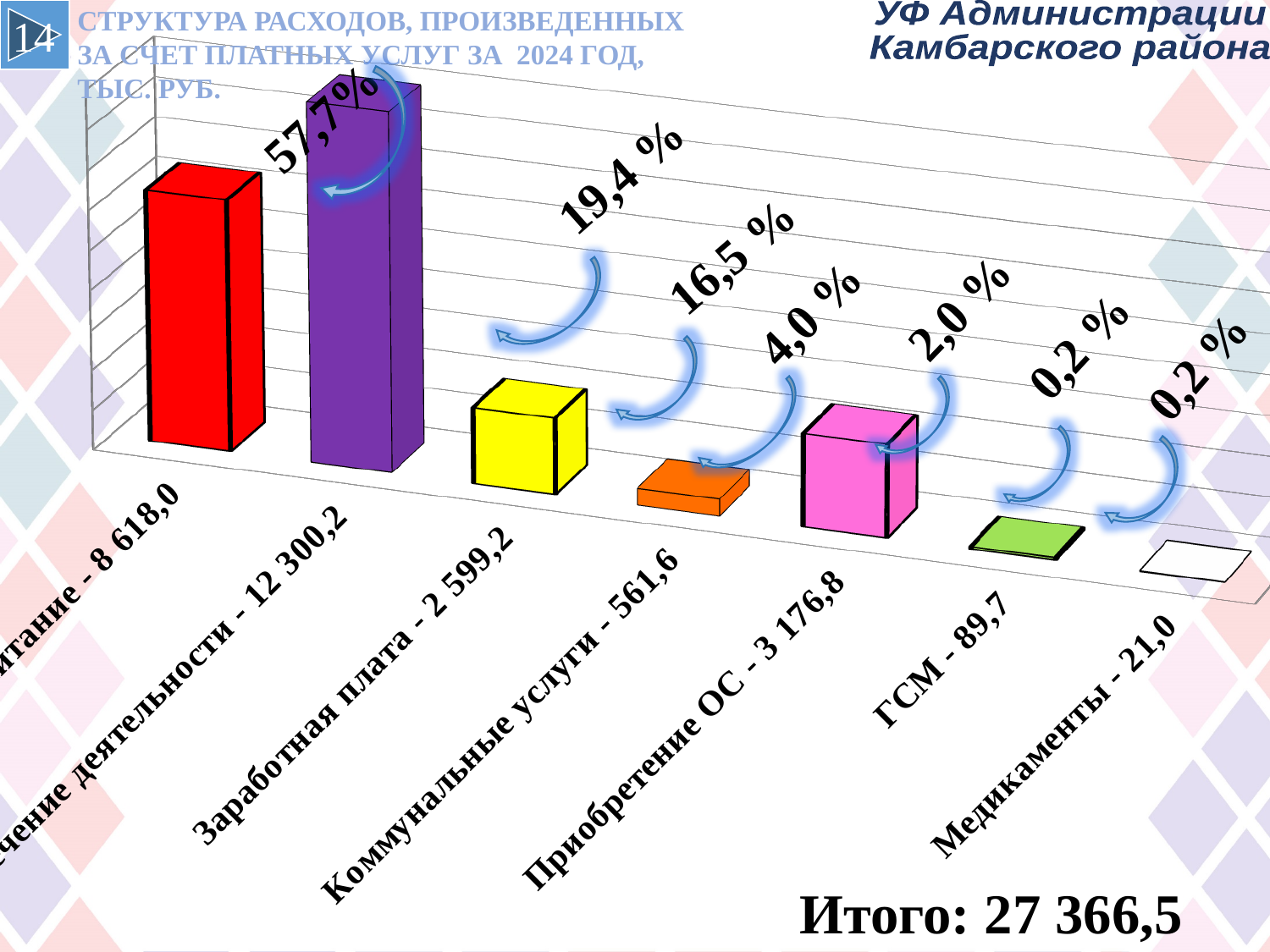
What is the difference between the values for Приобретение ОС and Заработная плата? 577,6 What kind of chart is shown on the slide? bar chart Which is larger, the value for Заработная плата or the value for Приобретение ОС? Приобретение ОС What is the value for Приобретение ОС? 3 176,8 What is the value for Коммунальные услуги? 561,6 What is the value for Медикаменты? 21,0 What total (Итого) is printed on the slide? 27 366,5 How many categories are shown in the chart? 7 What is the value for ГСМ? 89,7 What is the value for Заработная плата? 2 599,2 Which category has the lowest value? Медикаменты Which category has the highest value? Обеспечение деятельности